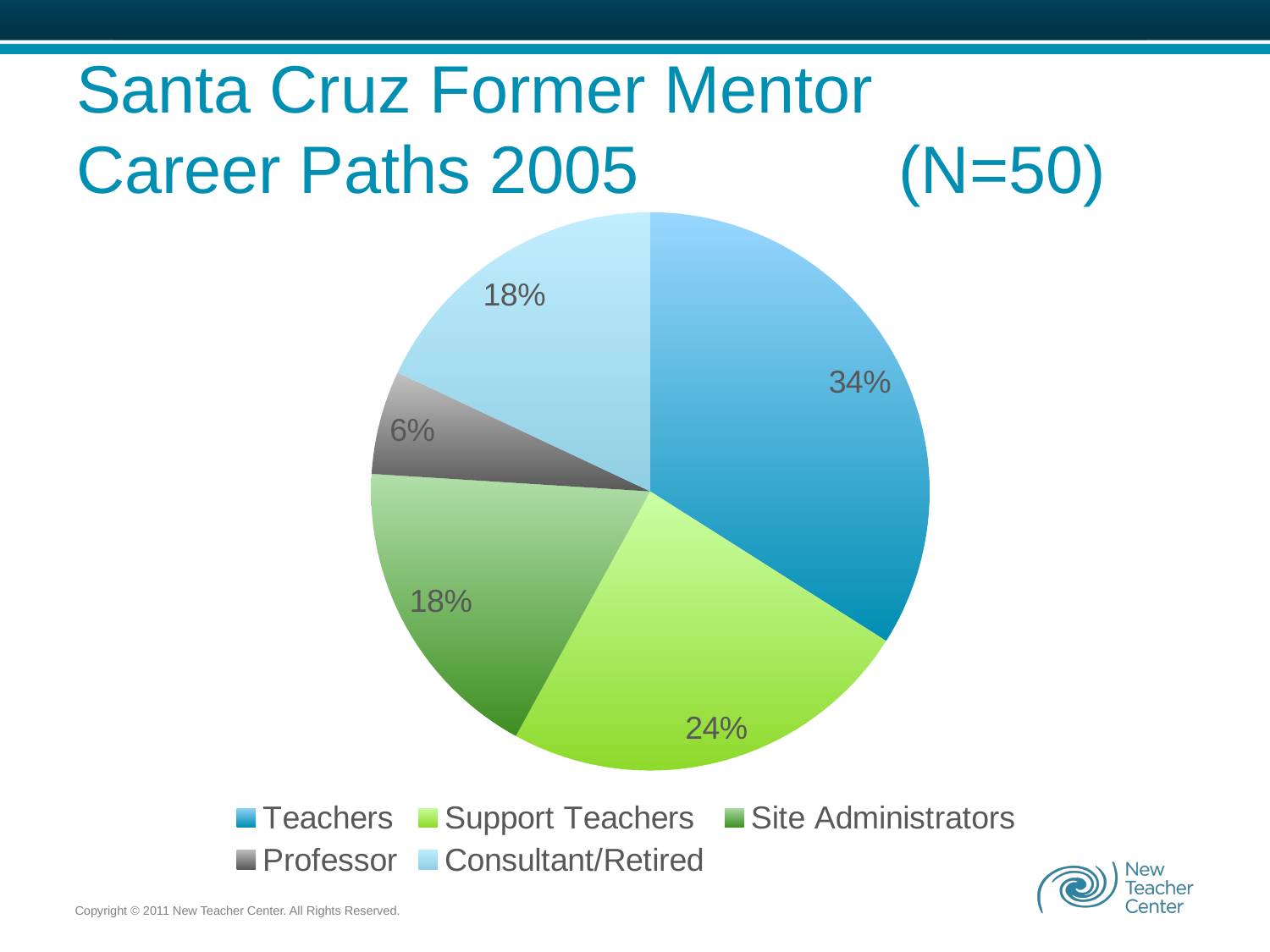
What percentage of former mentors became Support Teachers? 24% Which is larger, the share for Support Teachers or the share for Consultant/Retired? Support Teachers How many entries does the legend list? 5 What is the difference in percentage points between Teachers and Support Teachers? 10 Which career path has the smallest share of the pie? Professor What percentage of former mentors became Teachers? 34% How many career path categories are shown in the pie chart? 5 What is the sample size (N) stated in the slide title? 50 Which career path has the largest share of the pie? Teachers What percentage of former mentors became Professors? 6% What percentage of former mentors became Site Administrators? 18% What type of chart is shown on the slide? Pie chart